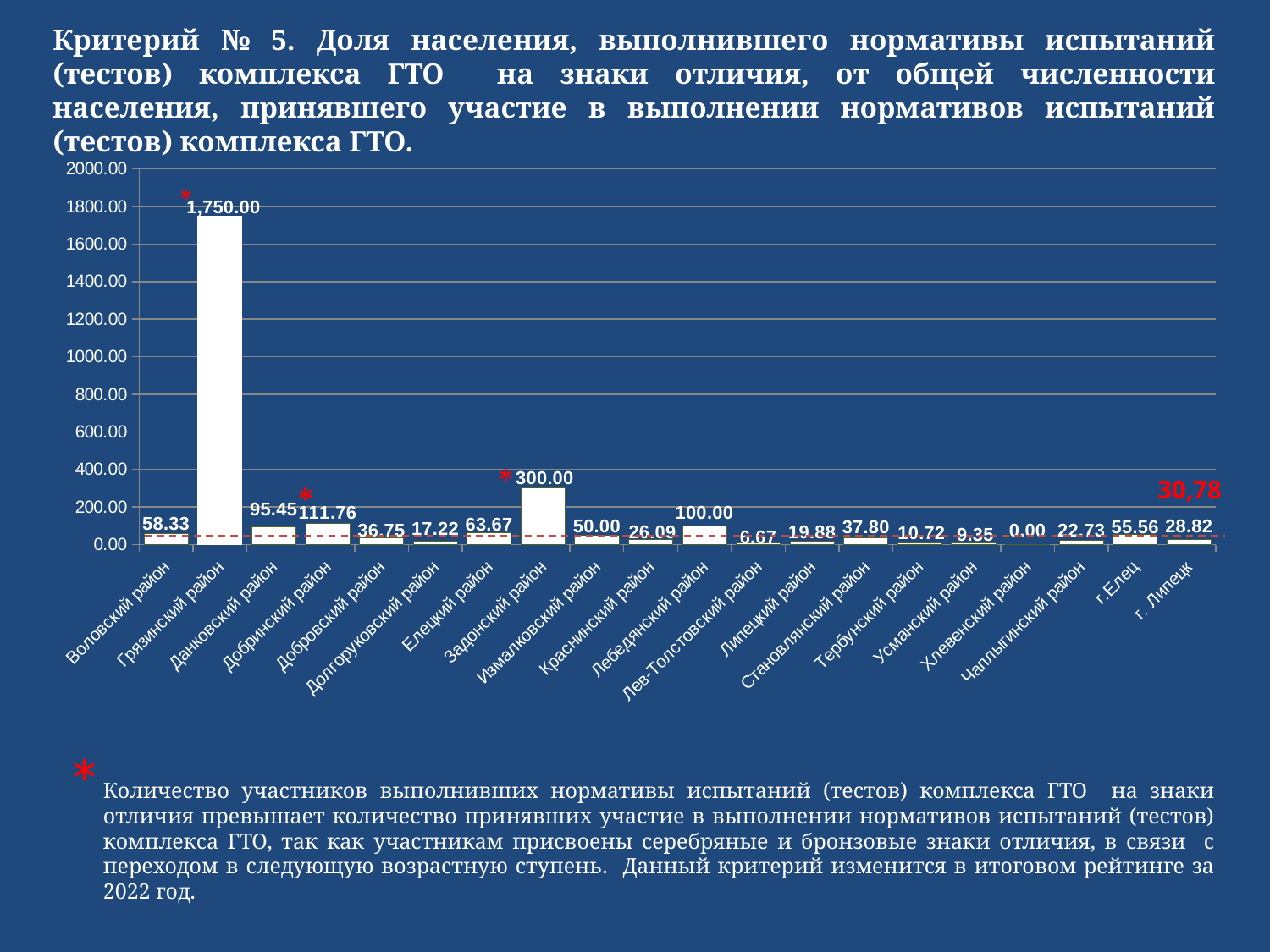
What is the value for Лев-Толстовский район? 6.67 Which is larger, the value for Данковский район or the value for Добринский район? Добринский район What kind of chart is shown on the slide? bar chart What is the value for г. Липецк? 28.82 Which category has the lowest value? Хлевенский район What value is labelled in red next to the dashed horizontal line? 30,78 What is the value for Задонский район? 300.00 What is the difference between the values for Грязинский район and Задонский район? 1,450.00 Which category has the highest value? Грязинский район What is the value for Грязинский район? 1,750.00 How many categories are shown on the x axis? 20 Is the value for Лебедянский район greater or less than 200.00? less